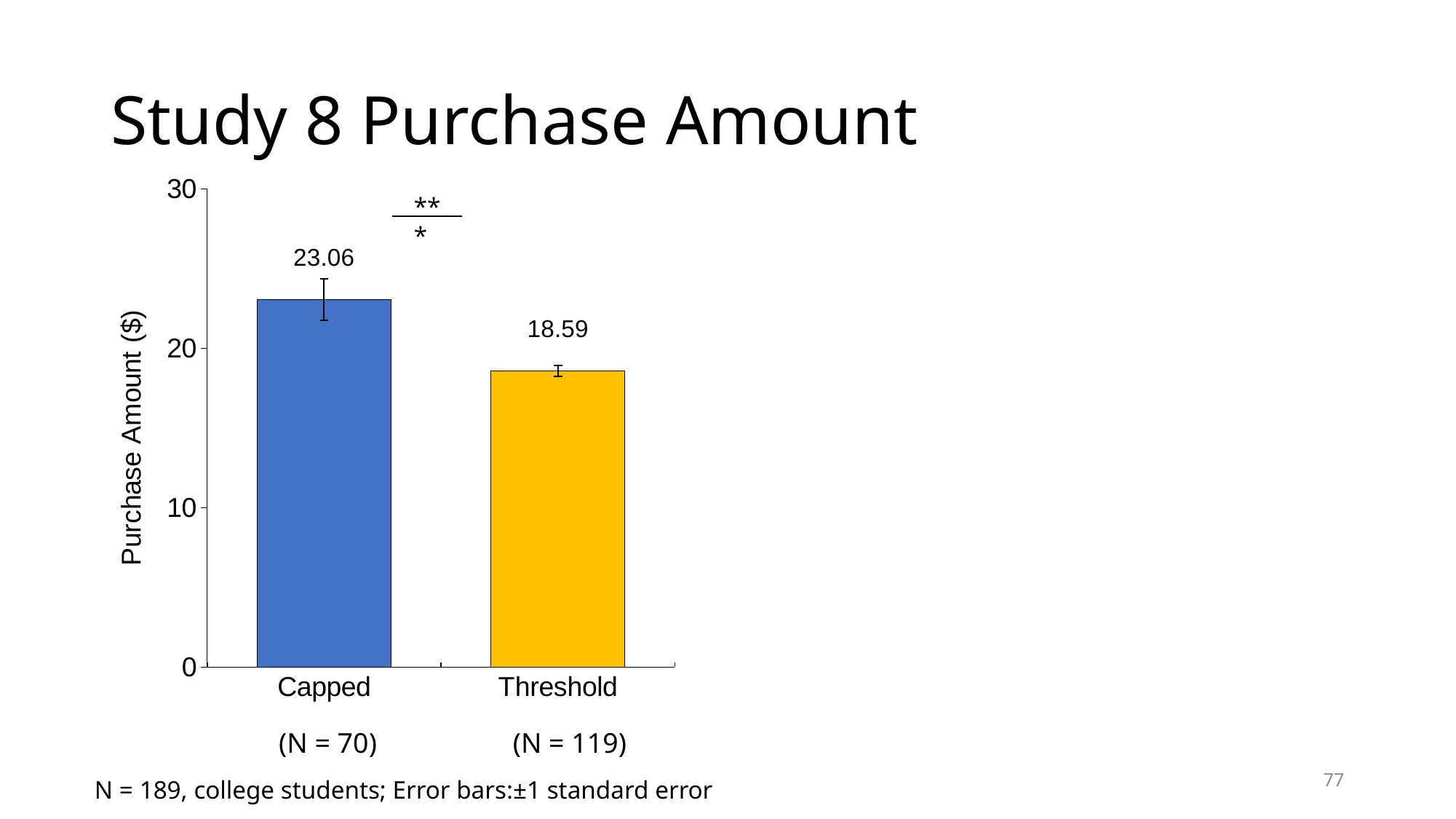
Which condition has the higher purchase amount? Capped Is the value for Capped greater or less than 20? greater What is the label of the y axis? Purchase Amount ($) What kind of chart is shown on the slide? bar chart What is the purchase amount for the Threshold condition? 18.59 Which condition has the lower purchase amount? Threshold What is the purchase amount for the Capped condition? 23.06 What is the sample size (N) for the Threshold condition? 119 What is the difference in purchase amount between the Capped and Threshold conditions? 4.47 How many conditions (bars) are shown in the chart? 2 Is the value for Threshold greater or less than 20? less Is the purchase amount for Capped larger or smaller than for Threshold? larger